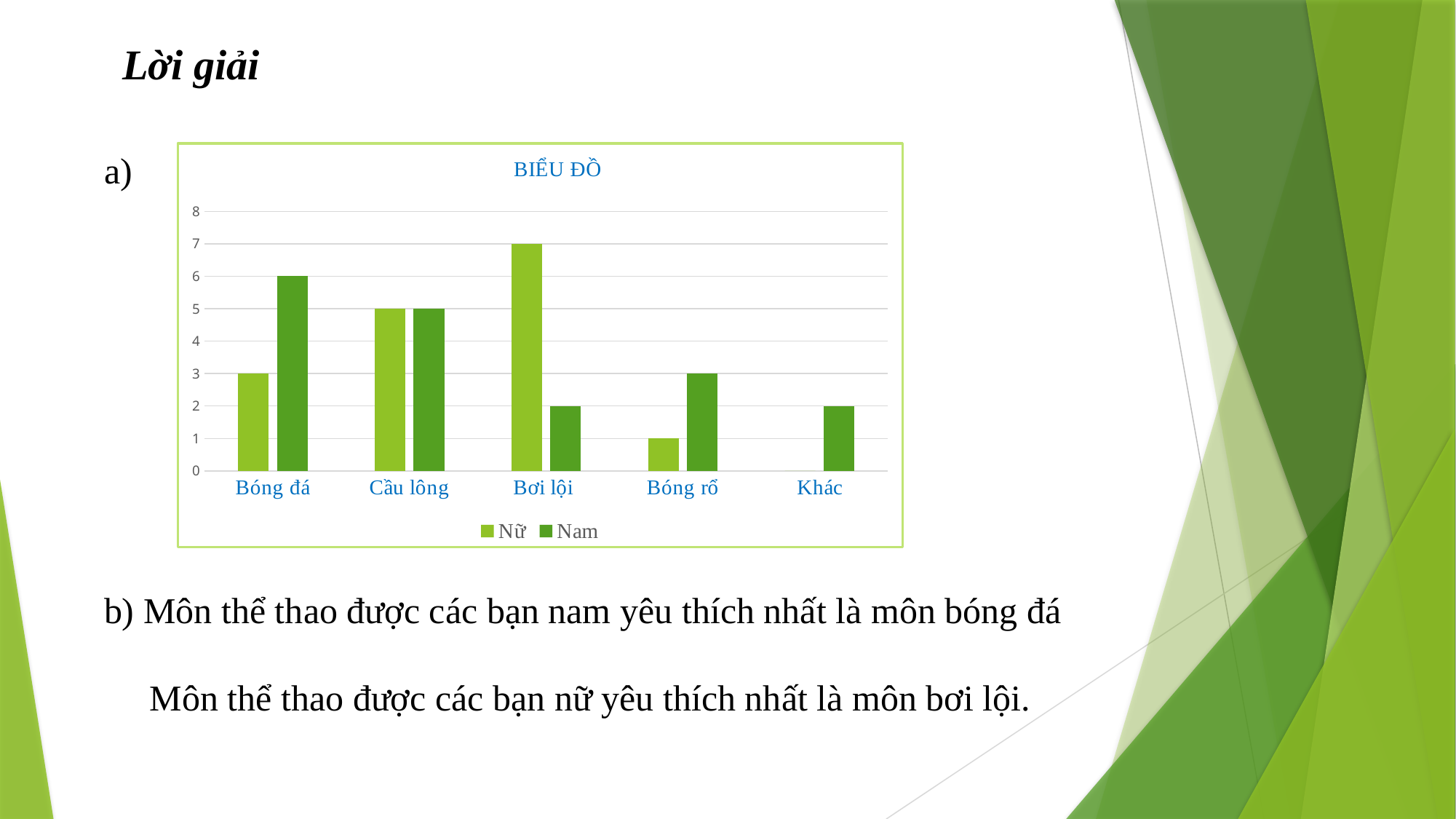
What is the value for Nữ in the Bơi lội category? 7 Is the value for Nữ in the Cầu lông category greater or less than 4? greater Which category has the lowest value for Nam? Bơi lội and Khác How many series does the legend list? 2 What type of chart is shown on the slide? bar chart What is the value for Nam in the Khác category? 2 What is the title of the chart? BIỂU ĐỒ What is the value for Nam in the Bóng đá category? 6 How many categories are shown on the x axis? 5 What is the difference between the Nữ and Nam values in the Bóng đá category? 3 Which category has the highest value for Nữ? Bơi lội Which is larger in the Bóng rổ category, the Nữ value or the Nam value? Nam